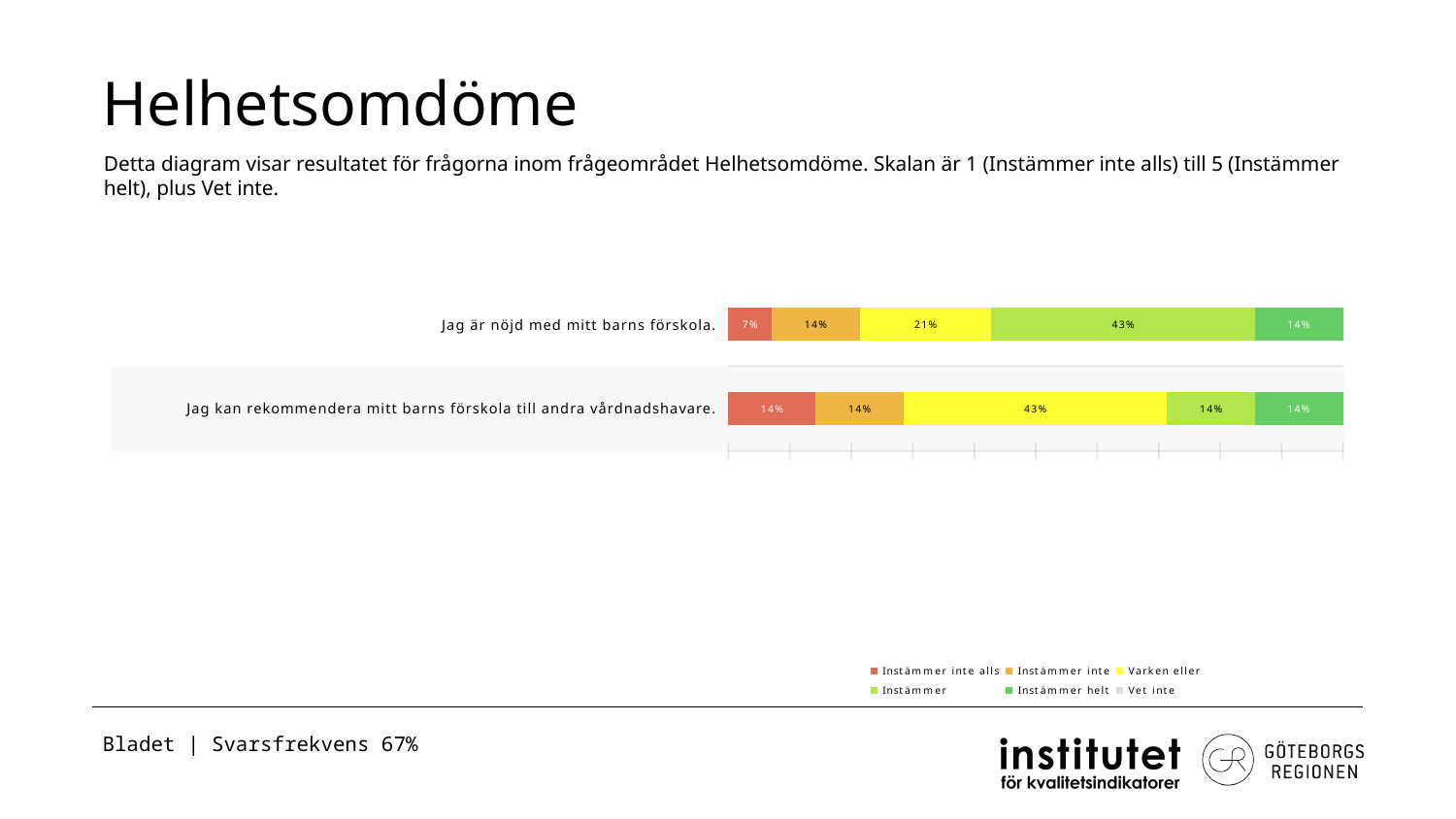
Which is larger for 'Jag kan rekommendera mitt barns förskola till andra vårdnadshavare.': the 'Varken eller' share or the 'Instämmer' share? Varken eller What is the value of the 'Instämmer' (light green) segment for 'Jag är nöjd med mitt barns förskola.'? 43% What is the value of the 'Varken eller' (yellow) segment for 'Jag kan rekommendera mitt barns förskola till andra vårdnadshavare.'? 43% Which legend entry is shown in red? Instämmer inte alls What is the value of the 'Instämmer inte alls' (red) segment for 'Jag är nöjd med mitt barns förskola.'? 7% What kind of chart is shown on the slide? Stacked bar chart How many series does the legend list? 6 How many categories (statements) are plotted in the chart? 2 Which response category has the largest share for 'Jag är nöjd med mitt barns förskola.'? Instämmer What is the difference between the 'Instämmer' share and the 'Varken eller' share for 'Jag är nöjd med mitt barns förskola.'? 22% Which response category has the smallest share for 'Jag är nöjd med mitt barns förskola.'? Instämmer inte alls What is the value of the 'Instämmer helt' (dark green) segment for 'Jag kan rekommendera mitt barns förskola till andra vårdnadshavare.'? 14%